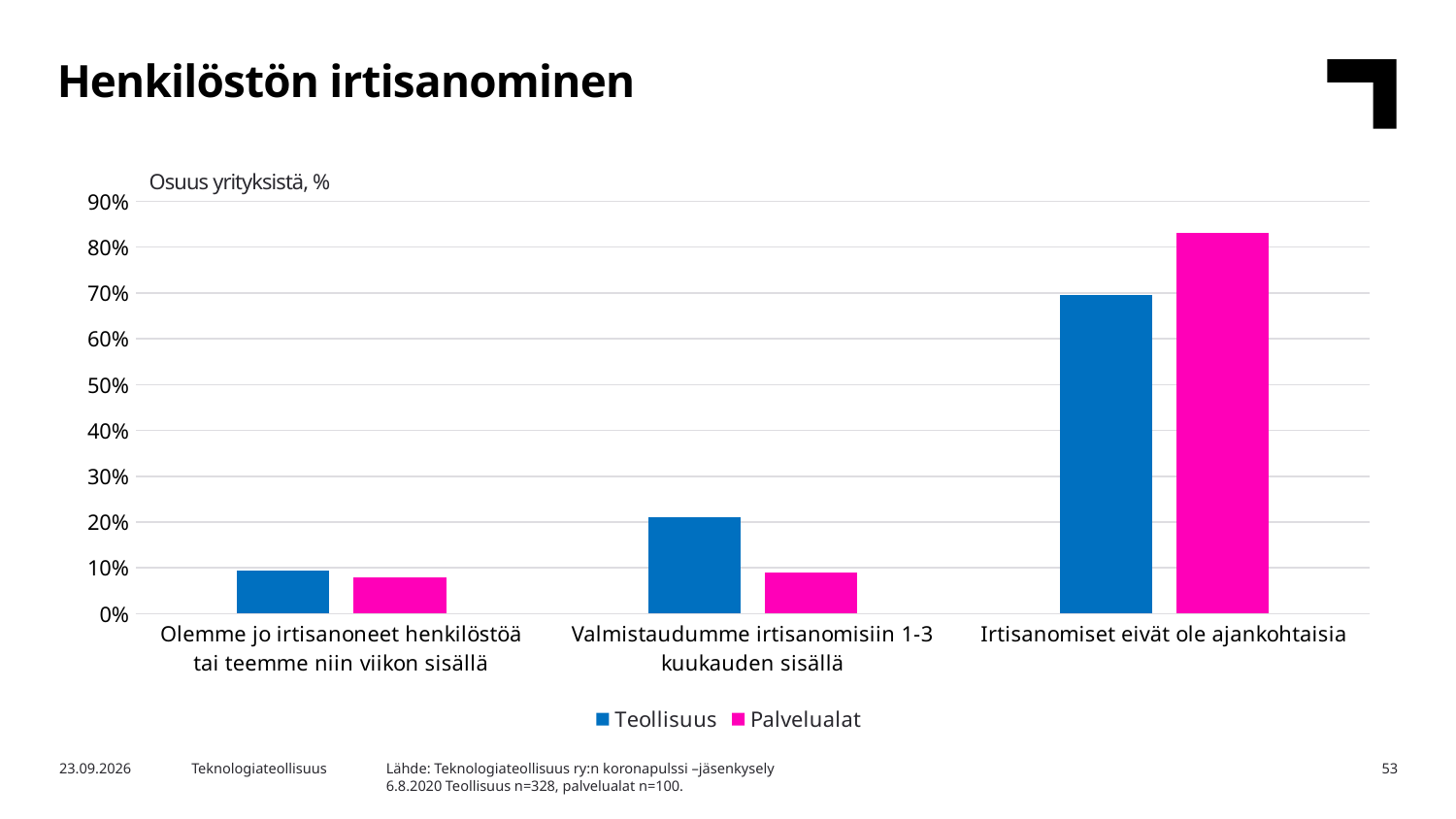
What kind of chart is shown on the slide? bar chart Which category has the highest value for Palvelualat? Irtisanomiset eivät ole ajankohtaisia Which category has the lowest value for Teollisuus? Olemme jo irtisanoneet henkilöstöä tai teemme niin viikon sisällä For 'Irtisanomiset eivät ole ajankohtaisia', which series has the larger value, Teollisuus or Palvelualat? Palvelualat Which category has the highest value for Teollisuus? Irtisanomiset eivät ole ajankohtaisia Is the Teollisuus value for 'Irtisanomiset eivät ole ajankohtaisia' greater or less than 60%? greater For 'Valmistaudumme irtisanomisiin 1-3 kuukauden sisällä', which series has the larger value, Teollisuus or Palvelualat? Teollisuus What is the label shown above the y axis of the chart? Osuus yrityksistä, % How many series does the legend list? 2 Is the Palvelualat value for 'Valmistaudumme irtisanomisiin 1-3 kuukauden sisällä' greater or less than 20%? less How many categories are shown on the x axis? 3 Is the Palvelualat value for 'Irtisanomiset eivät ole ajankohtaisia' greater or less than 70%? greater